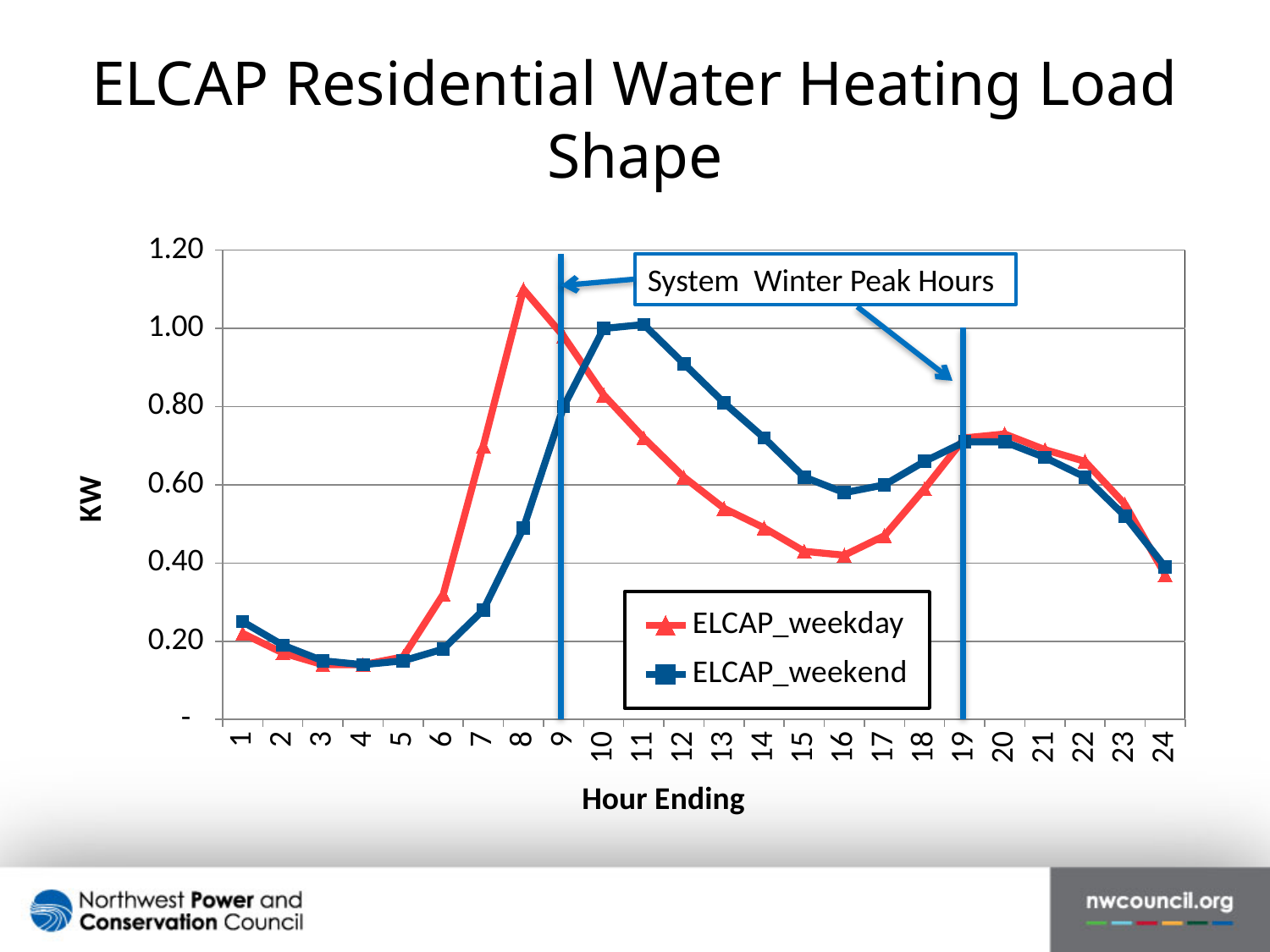
At hour ending 8, which series has the higher value, ELCAP_weekday or ELCAP_weekend? ELCAP_weekday Is the ELCAP_weekend value at hour ending 8 greater or less than 0.60? less How many series does the legend list? 2 At which hour ending does the ELCAP_weekday series reach its highest value? 8 Is the ELCAP_weekend value at hour ending 14 greater or less than 0.60? greater How many hour-ending points are plotted along the x axis? 24 Does the ELCAP_weekday series rise or fall from hour ending 8 to hour ending 16? fall Is the ELCAP_weekday value at hour ending 8 greater or less than 1.00? greater What kind of chart is shown on the slide? Line chart At hour ending 10, which series has the higher value, ELCAP_weekday or ELCAP_weekend? ELCAP_weekend What is the label on the y axis of the chart? KW